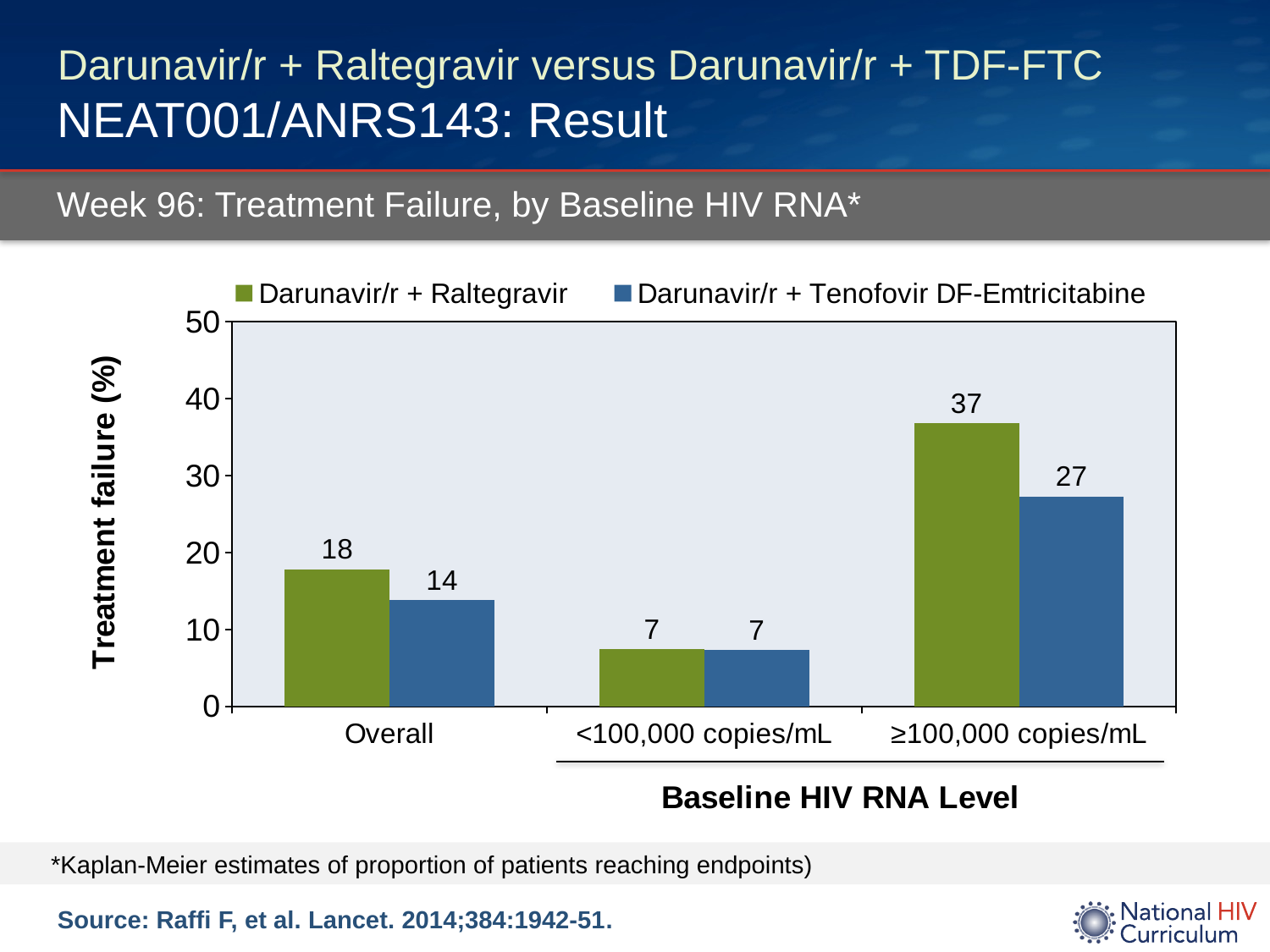
What is the treatment failure percentage for Darunavir/r + Raltegravir in the Overall group? 18 Which baseline HIV RNA category has the highest treatment failure for Darunavir/r + Raltegravir? ≥100,000 copies/mL In the Overall group, which regimen has the higher treatment failure? Darunavir/r + Raltegravir Which category has the lowest treatment failure for Darunavir/r + Tenofovir DF-Emtricitabine? <100,000 copies/mL How many series does the legend list? 2 What is the treatment failure percentage for Darunavir/r + Raltegravir in the <100,000 copies/mL group? 7 What is the difference in treatment failure between the two regimens in the Overall group? 4 Is the treatment failure for Darunavir/r + Raltegravir in the ≥100,000 copies/mL group greater or less than 30? greater What is the difference in treatment failure between Darunavir/r + Raltegravir and Darunavir/r + Tenofovir DF-Emtricitabine in the ≥100,000 copies/mL group? 10 How many categories are shown on the x axis? 3 What is the treatment failure percentage for Darunavir/r + Tenofovir DF-Emtricitabine in the ≥100,000 copies/mL group? 27 What kind of chart is shown on the slide? Bar chart